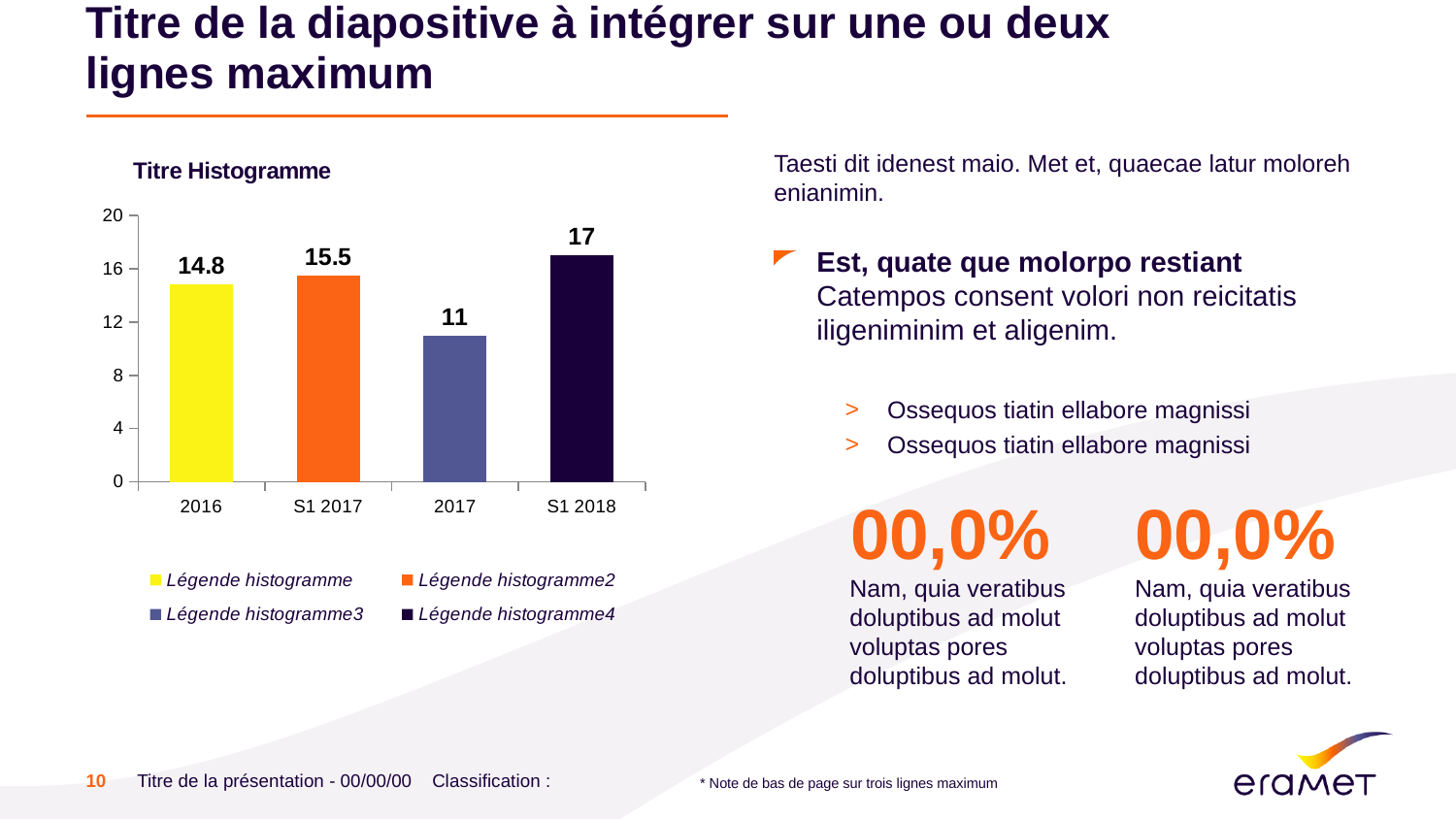
How many entries does the chart legend list? 4 Which category has the highest value in the chart? S1 2018 How many categories are shown on the x axis of the chart? 4 What is the value for 2016 in the chart? 14.8 What kind of chart is shown on the slide? Bar chart What is the value for S1 2017 in the chart? 15.5 What is the value for S1 2018 in the chart? 17 What is the difference between the values for S1 2018 and 2017? 6 Which category has the lowest value in the chart? 2017 What is the value for 2017 in the chart? 11 Which is larger, the value for 2016 or the value for S1 2017? S1 2017 What is the title of the chart? Titre Histogramme